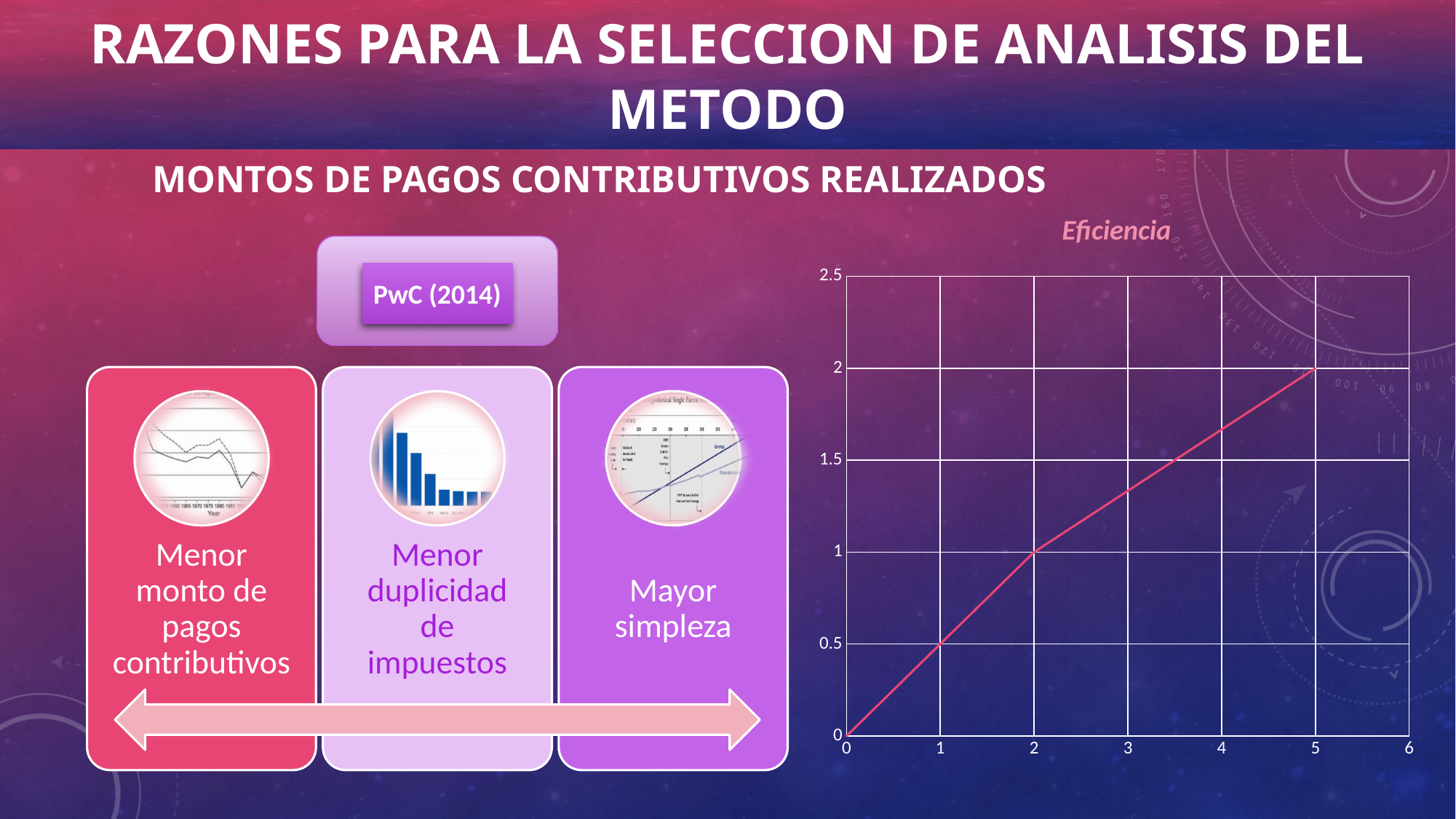
In the "Eficiencia" chart, what is the value of the line at x = 5? 2 In the "Eficiencia" chart, what is the difference between the value at x = 5 and the value at x = 2? 1 In the "Eficiencia" chart, what is the value of the line at x = 0? 0 What is the title of the chart on the right side of the slide? Eficiencia In the "Eficiencia" chart, is the value at x = 4 greater or less than 1.5? greater In the "Eficiencia" chart, do the values rise or fall as the x axis increases? rise What kind of chart is the "Eficiencia" chart? line chart In the "Eficiencia" chart, which is larger: the value at x = 5 or the value at x = 2? x = 5 In the "Eficiencia" chart, is the value at x = 3 greater or less than 1? greater In the "Eficiencia" chart, is the value at x = 3 greater or less than 1.5? less In the "Eficiencia" chart, what is the value of the line at x = 2? 1